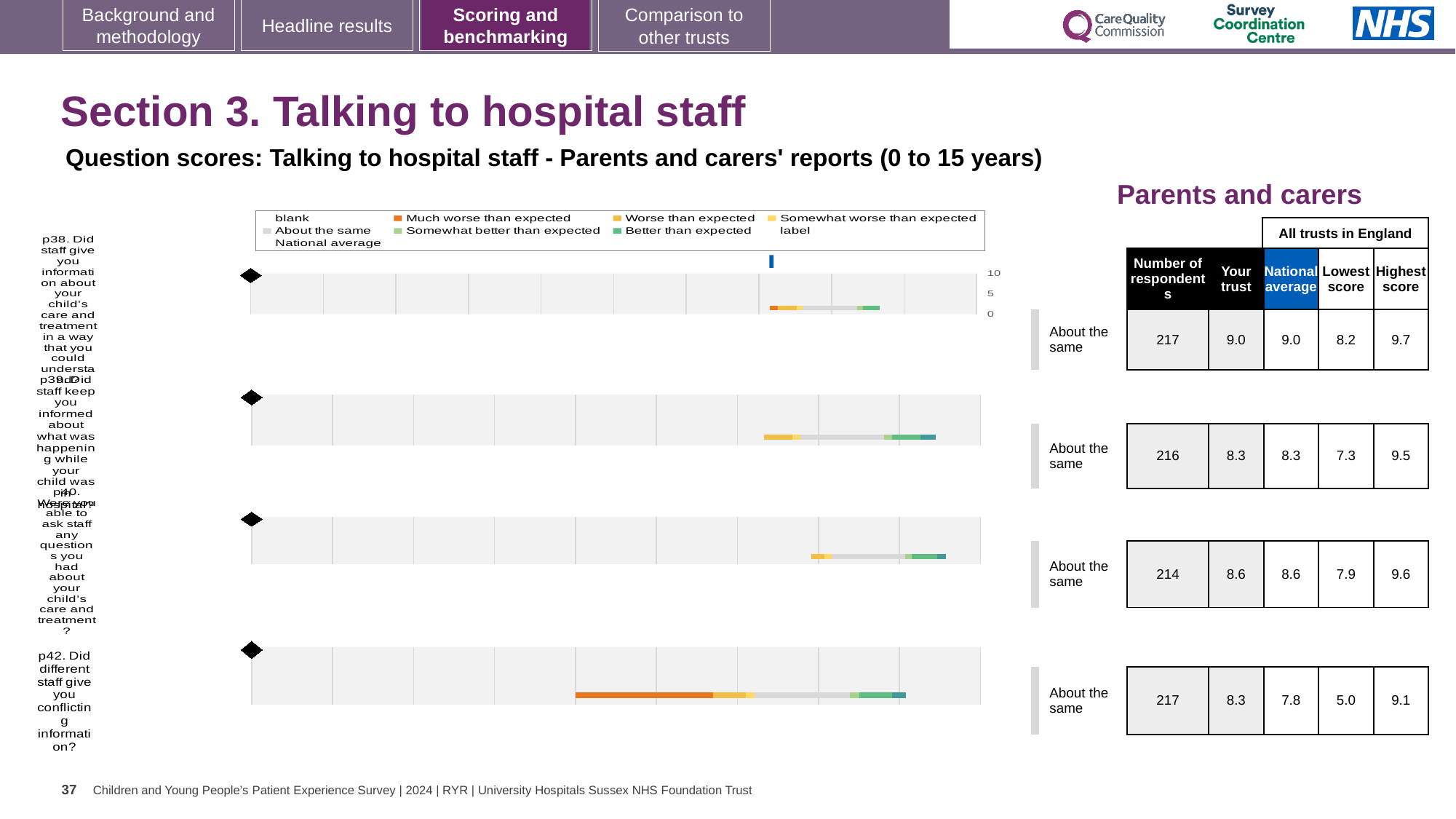
How many entries does the legend above the charts list? 9 What is the 'Number of respondents' shown for the p40 chart row (able to ask staff any questions)? 214 What benchmark label is shown next to each of the four chart rows? About the same For the p42 row, what is the difference between the 'Your trust' score and the 'National average'? 0.5 Which question row has the lowest 'Lowest score' value? p42 What is the 'Highest score' shown for the p39 chart row (staff keep you informed)? 9.5 How many question charts (rows) are shown on the slide? 4 What is the 'Your trust' score shown for the p38 chart row (information about your child's care and treatment)? 9.0 What is the 'National average' shown for the p42 chart row (conflicting information)? 7.8 Which question row has the highest 'Your trust' score? p38 Which is larger: the 'Lowest score' for the p39 row or for the p40 row? p40 What kind of chart is used for each question row on the slide? bar chart